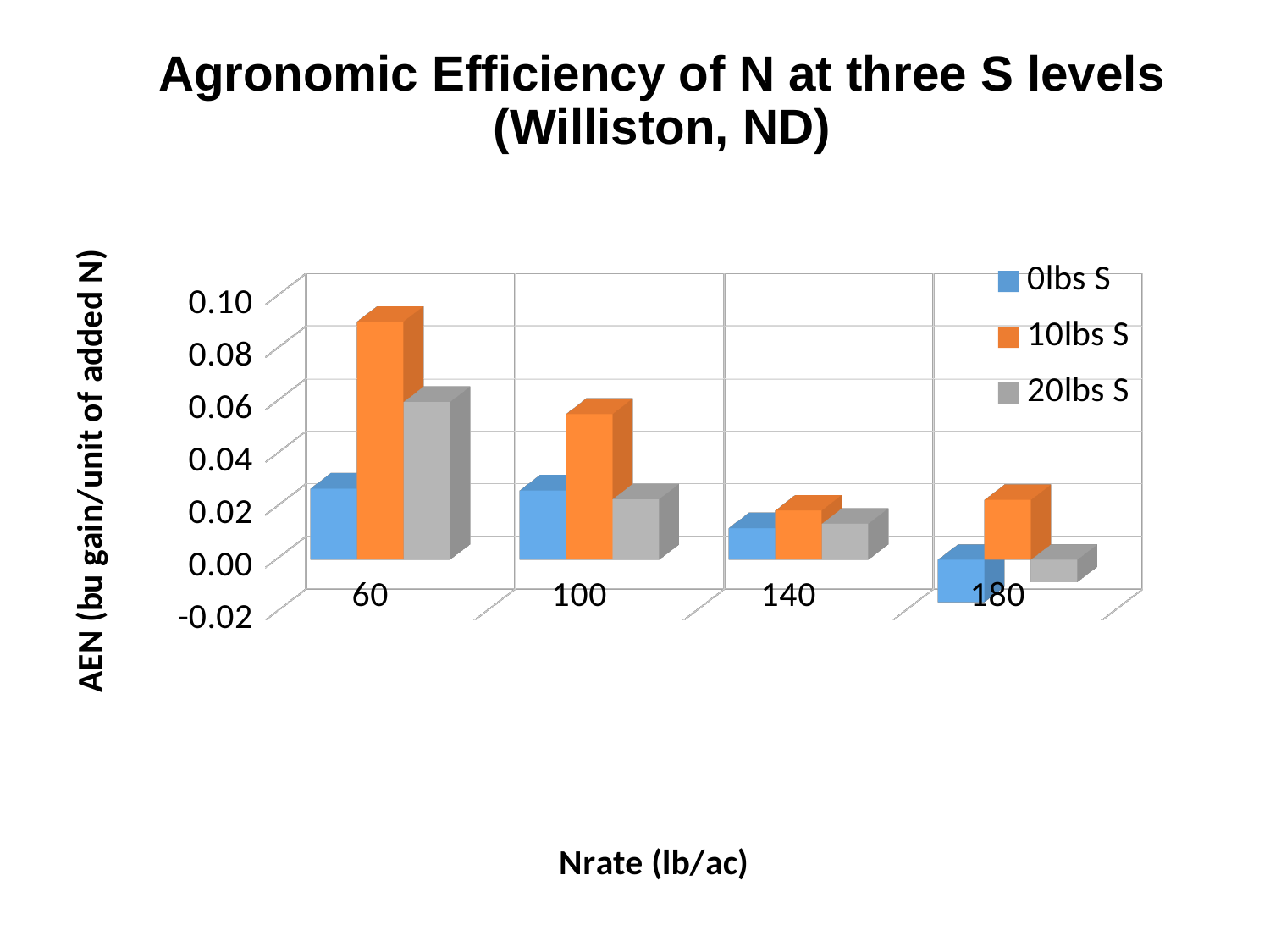
How many N rate categories are shown on the x axis? 4 At an N rate of 180, which is larger: the 0lbs S value or the 10lbs S value? 10lbs S Do the 20lbs S values rise or fall as the N rate increases from 60 to 180? fall At which N rate is the 0lbs S value lowest? 180 Is the 10lbs S value at an N rate of 60 greater or less than 0.06? greater Is the 10lbs S value at an N rate of 100 greater or less than 0.04? greater At which N rate is the 10lbs S value highest? 60 Is the 0lbs S value at an N rate of 180 greater or less than 0.00? less What is the title of the y axis? AEN (bu gain/unit of added N) How many series does the legend list? 3 What kind of chart is shown on the slide? Bar chart At an N rate of 60, which is larger: the 10lbs S value or the 20lbs S value? 10lbs S